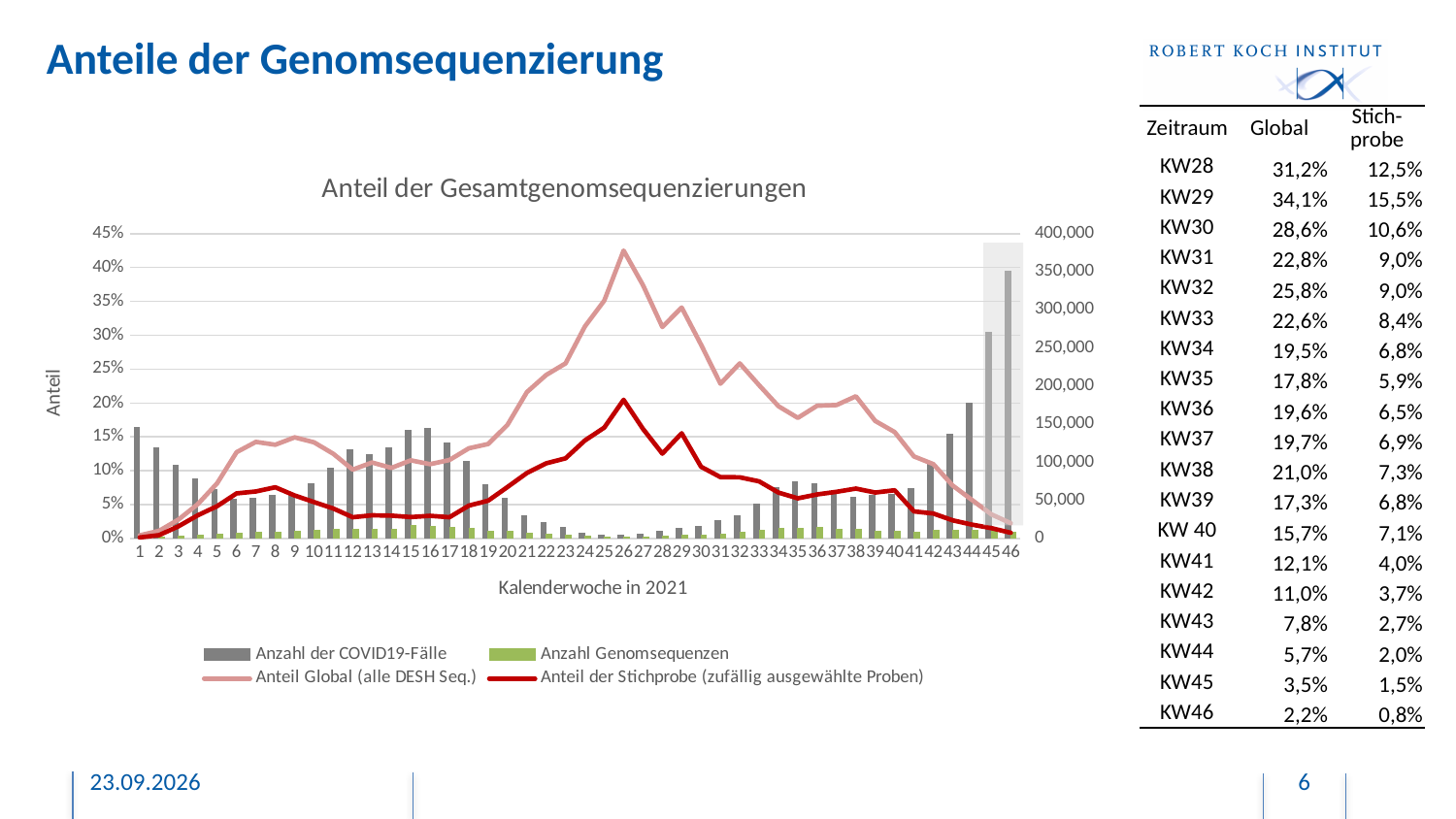
According to the table next to the chart, what is the Global share for KW28? 31,2% Does the 'Anteil Global (alle DESH Seq.)' line rise or fall from calendar week 26 to week 46? fall Is the number of COVID19 cases in calendar week 46 greater or less than 300,000? greater How many calendar weeks are shown on the x axis of the chart? 46 How many series does the legend of the chart list? 4 What is the label of the x axis of the chart? Kalenderwoche in 2021 In calendar week 26, which line is higher: 'Anteil Global' or 'Anteil der Stichprobe'? Anteil Global Is the value of 'Anteil Global (alle DESH Seq.)' in calendar week 26 greater or less than 40%? greater Is the value of 'Anteil der Stichprobe' in calendar week 26 greater or less than 15%? greater In which calendar week is the bar for 'Anzahl der COVID19-Fälle' the tallest? 46 What kind of chart is 'Anteil der Gesamtgenomsequenzierungen'? A combined bar and line chart In which calendar week does the 'Anteil Global (alle DESH Seq.)' line reach its highest value? 26